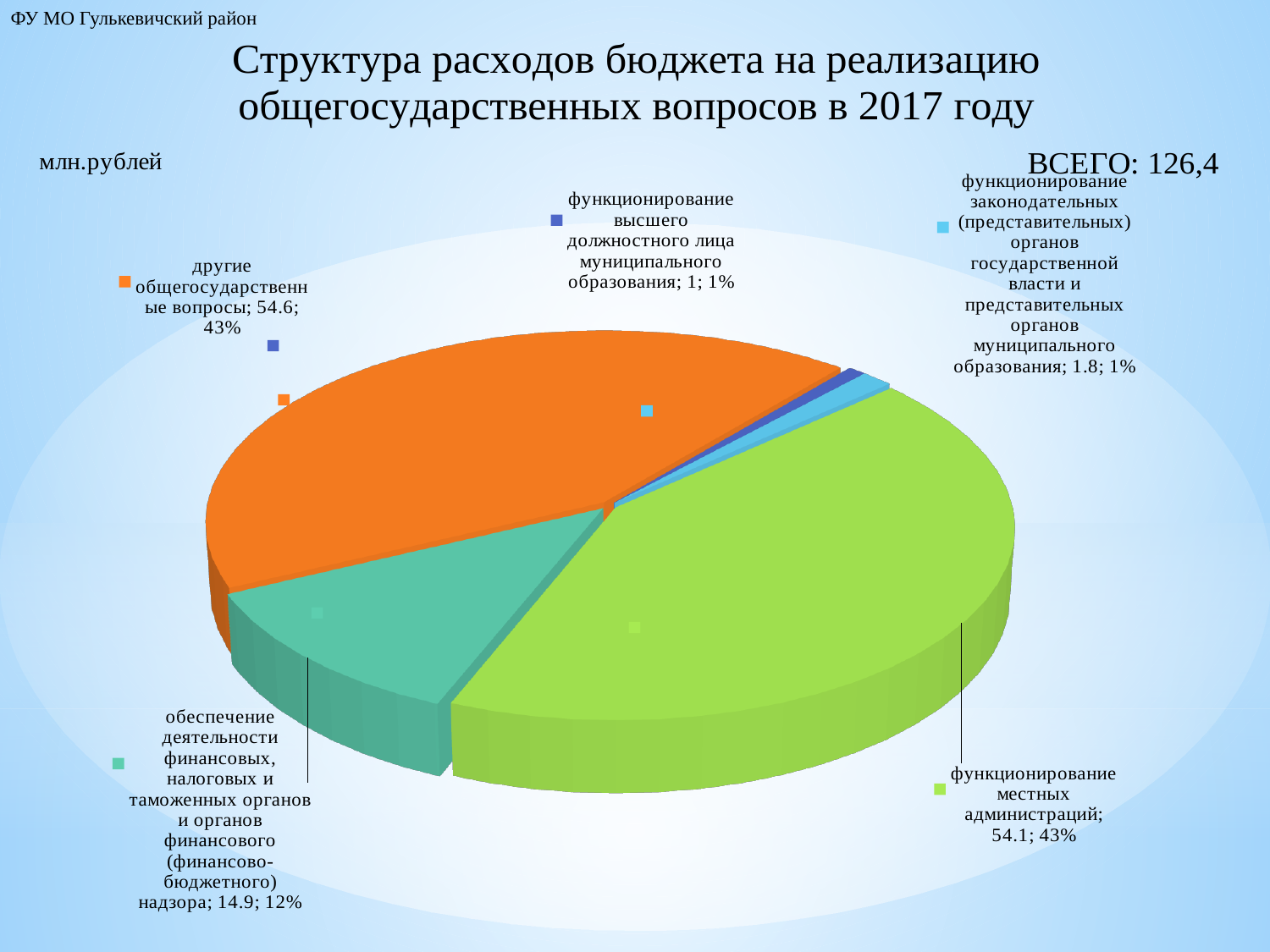
What is the value for 'функционирование местных администраций'? 54.1 What is the value for 'обеспечение деятельности финансовых, налоговых и таможенных органов и органов финансового (финансово-бюджетного) надзора'? 14.9 What is the difference between the values for 'другие общегосударственные вопросы' and 'обеспечение деятельности финансовых, налоговых и таможенных органов и органов финансового (финансово-бюджетного) надзора'? 39.7 Which category has the largest value? другие общегосударственные вопросы What is the value for 'функционирование законодательных (представительных) органов государственной власти и представительных органов муниципального образования'? 1.8 What total (ВСЕГО) is shown on the slide? 126,4 What is the value for 'другие общегосударственные вопросы'? 54.6 Which category has the smallest value? функционирование высшего должностного лица муниципального образования What share of the pie does 'функционирование местных администраций' represent? 43% What kind of chart is shown on the slide? pie chart What share of the pie does 'обеспечение деятельности финансовых, налоговых и таможенных органов и органов финансового (финансово-бюджетного) надзора' represent? 12% How many slices does the pie chart have? 5